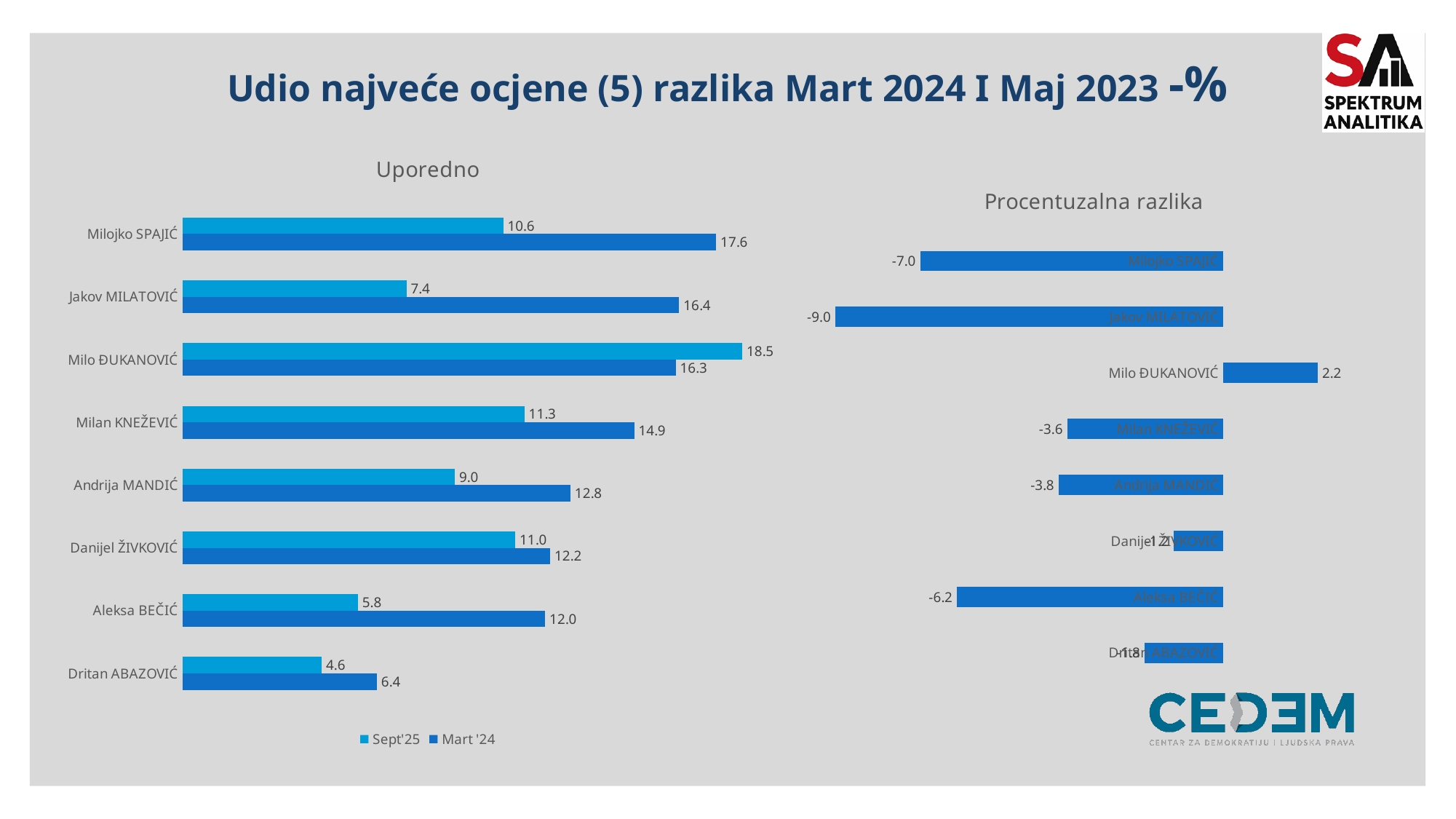
In the 'Uporedno' chart, which is larger for Milo ĐUKANOVIĆ: the Sept'25 value or the Mart '24 value? Sept'25 In the 'Uporedno' chart, what is the Mart '24 value for Jakov MILATOVIĆ? 16.4 In the 'Uporedno' chart, what is the Sept'25 value for Milojko SPAJIĆ? 10.6 In the 'Procentuzalna razlika' chart, which person is the only one with a positive value? Milo ĐUKANOVIĆ What type of chart is the 'Uporedno' chart? Bar chart In the 'Uporedno' chart, which person has the highest Sept'25 value? Milo ĐUKANOVIĆ In the 'Uporedno' chart, what is the difference between the Mart '24 and Sept'25 values for Aleksa BEČIĆ? 6.2 How many series does the legend of the 'Uporedno' chart list? 2 In the 'Procentuzalna razlika' chart, what is the value for Jakov MILATOVIĆ? -9.0 In the 'Uporedno' chart, which person has the lowest Mart '24 value? Dritan ABAZOVIĆ How many people are listed in the 'Uporedno' chart? 8 What are the two series named in the legend of the 'Uporedno' chart? Sept'25 and Mart '24